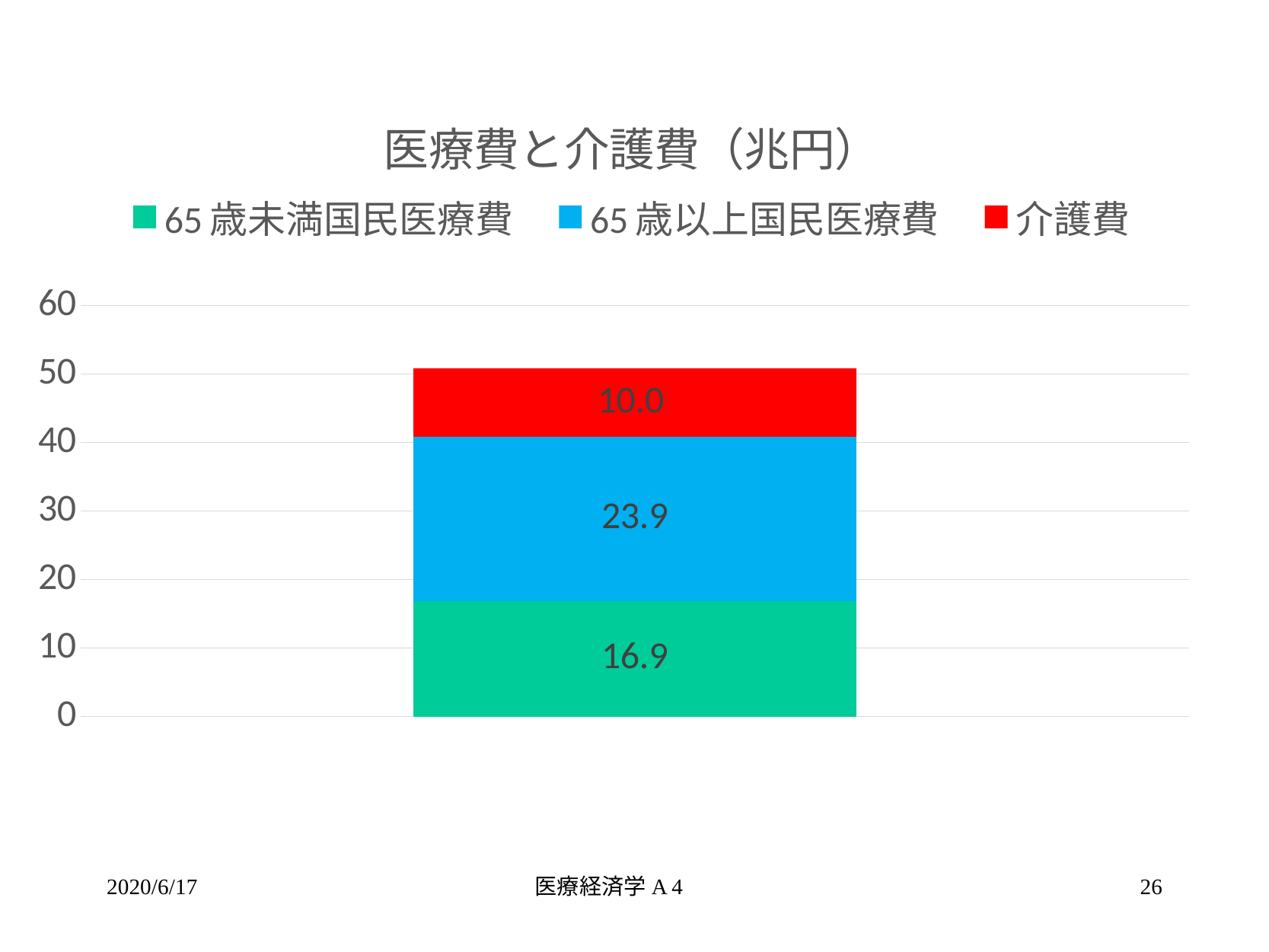
What is the total of the stacked bar? 50.8 How many series does the legend list? 3 What is the value for 65歳未満国民医療費? 16.9 What is the title of the chart? 医療費と介護費（兆円） Which is larger, 65歳未満国民医療費 or 介護費? 65歳未満国民医療費 What is the difference between 65歳以上国民医療費 and 65歳未満国民医療費? 7.0 What is the value for 介護費? 10.0 What is the value for 65歳以上国民医療費? 23.9 Which series has the smallest value in the stacked bar? 介護費 What kind of chart is shown on the slide? stacked bar chart Which series has the largest value in the stacked bar? 65歳以上国民医療費 Is the total of the stacked bar greater or less than 50? greater